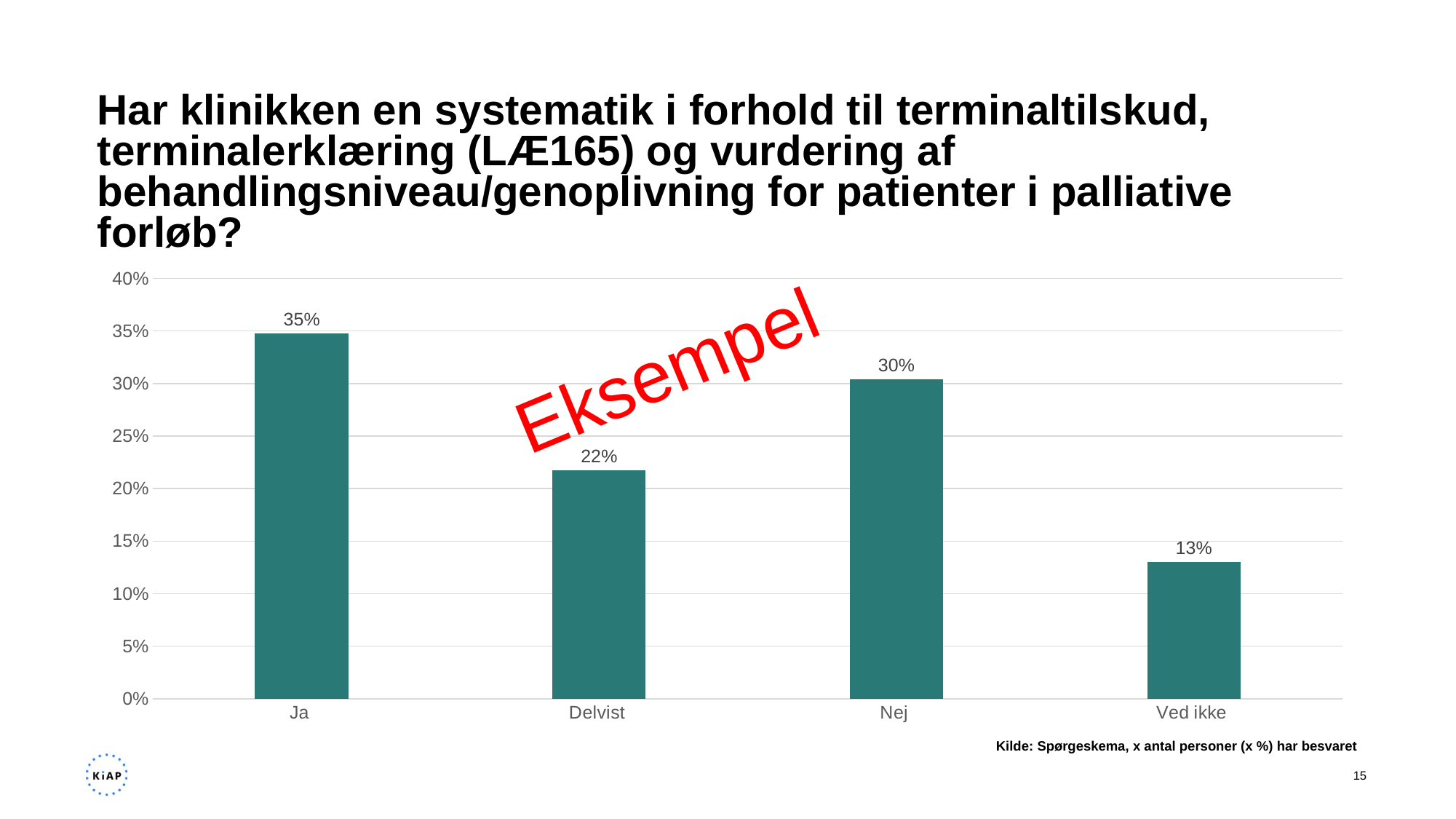
Is the value for Ved ikke greater or less than 15%? less What is the value for Nej? 30% What is the value for Ja? 35% Which category has the lowest value? Ved ikke Which category has the highest value? Ja What kind of chart is shown on the slide? bar chart What is the difference between the values for Ja and Nej? 5% What is the value for Ved ikke? 13% What is the value for Delvist? 22% What is the difference between the values for Delvist and Ved ikke? 9% How many categories are shown on the x axis? 4 Which is larger, the value for Delvist or the value for Nej? Nej